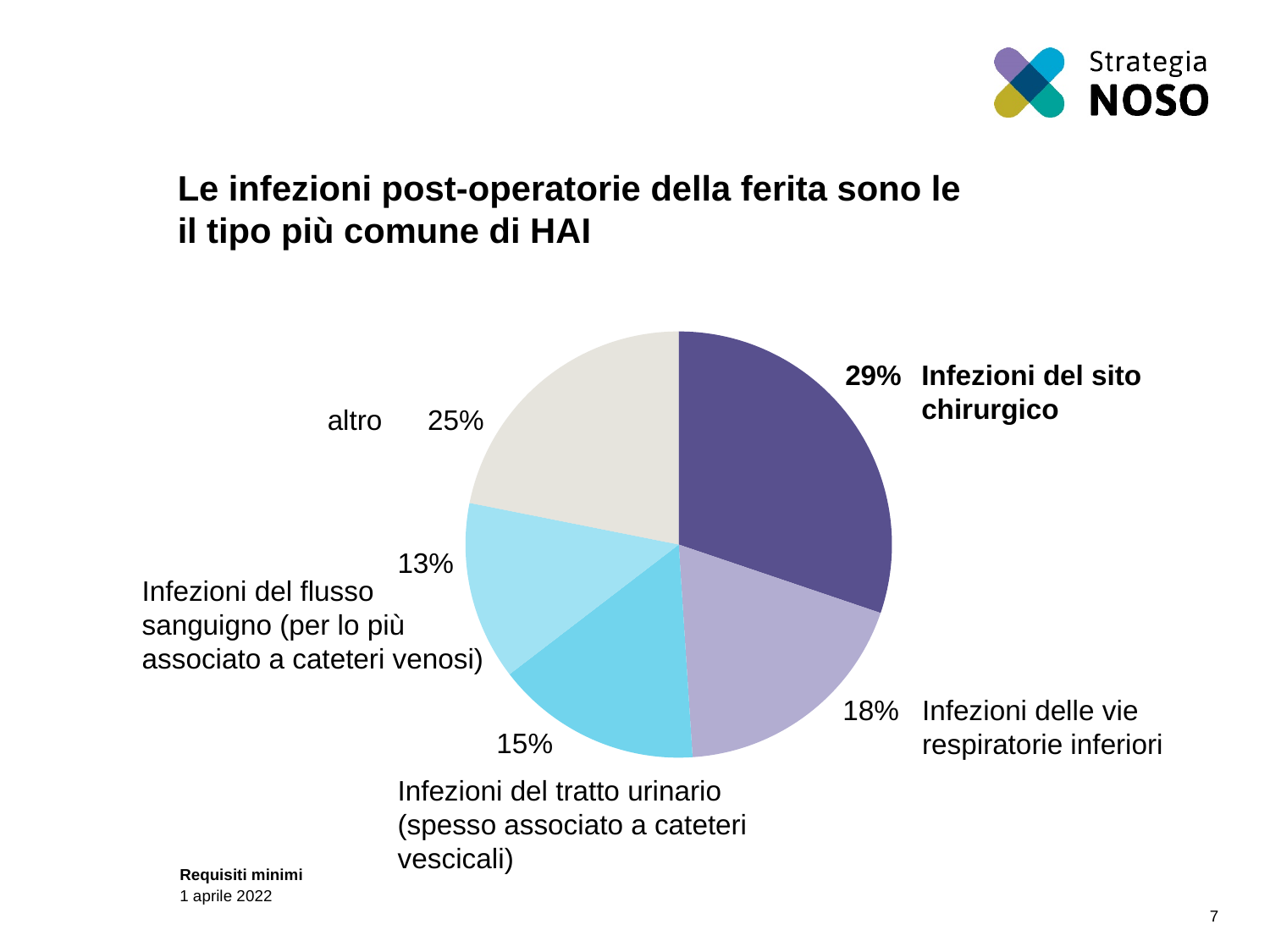
What is the title of the slide containing the pie chart? Le infezioni post-operatorie della ferita sono le il tipo più comune di HAI Which is larger: the share for altro or the share for Infezioni del tratto urinario? altro What is the difference in percentage points between Infezioni del sito chirurgico and Infezioni delle vie respiratorie inferiori? 11 What percentage is shown for Infezioni del flusso sanguigno? 13% What percentage is shown for Infezioni delle vie respiratorie inferiori? 18% What percentage is shown for the slice labelled altro? 25% What kind of chart is shown on the slide? Pie chart Which category has the smallest share of the pie? Infezioni del flusso sanguigno What percentage is shown for Infezioni del sito chirurgico? 29% Which category has the largest share of the pie? Infezioni del sito chirurgico What percentage is shown for Infezioni del tratto urinario? 15% How many slices does the pie chart have? 5